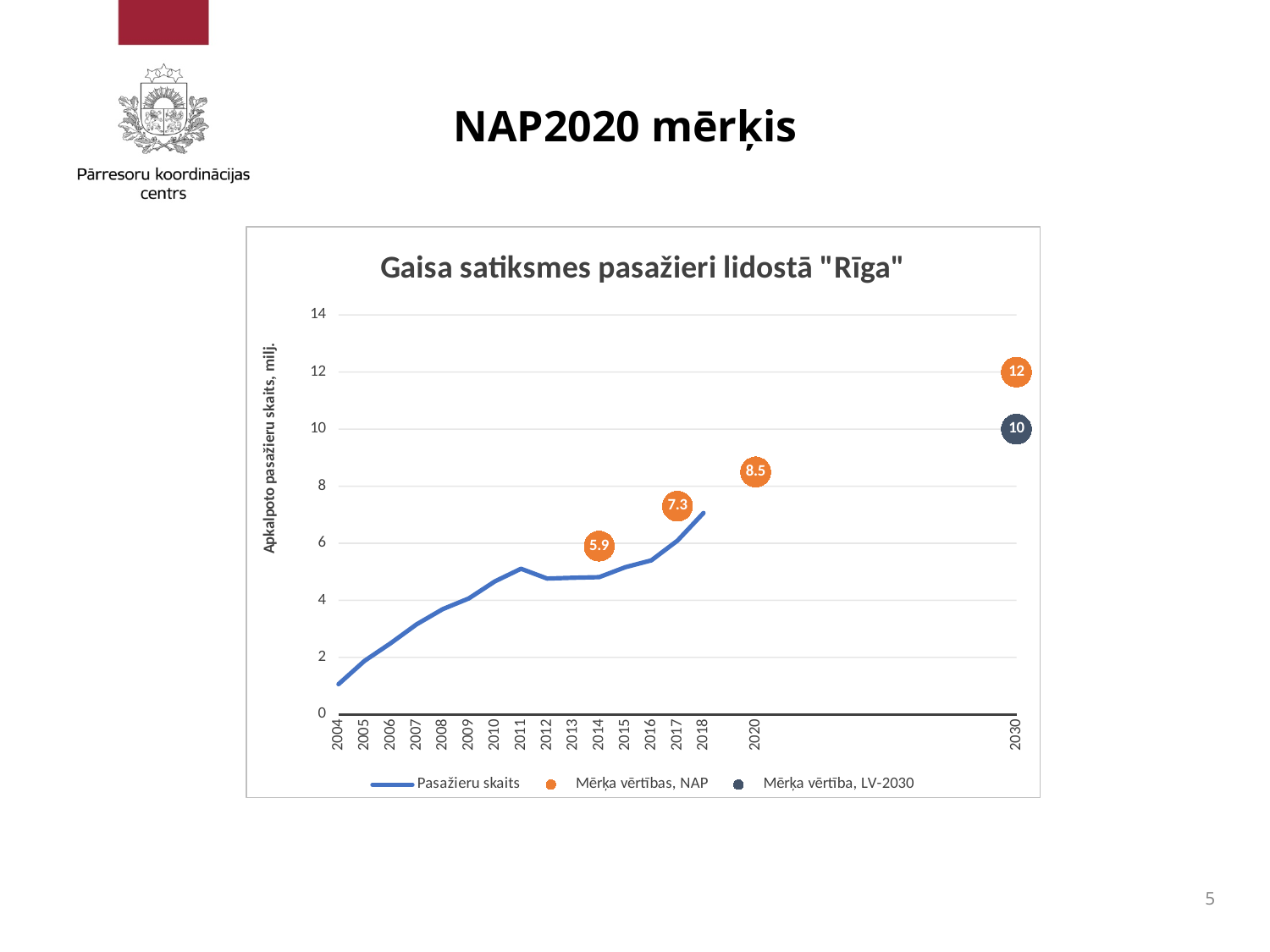
Is the Pasažieru skaits value for 2004 greater or less than 2? less Does the Pasažieru skaits line generally rise or fall from 2004 to 2018? rise What is the NAP target value (Mērķa vērtības, NAP) shown for 2017? 7.3 What is the difference between the NAP target for 2030 and the LV-2030 target for 2030? 2 What is the title of the chart? Gaisa satiksmes pasažieri lidostā "Rīga" What is the NAP target value (Mērķa vērtības, NAP) shown for 2020? 8.5 Is the Pasažieru skaits value for 2018 greater or less than 6? greater What is the difference between the NAP target values for 2020 and 2017? 1.2 What is the NAP target value (Mērķa vērtības, NAP) shown for 2014? 5.9 What is the LV-2030 target value (Mērķa vērtība, LV-2030) shown for 2030? 10 How many series does the legend list? 3 Which is larger for 2030: the NAP target value or the LV-2030 target value? NAP target value (12)